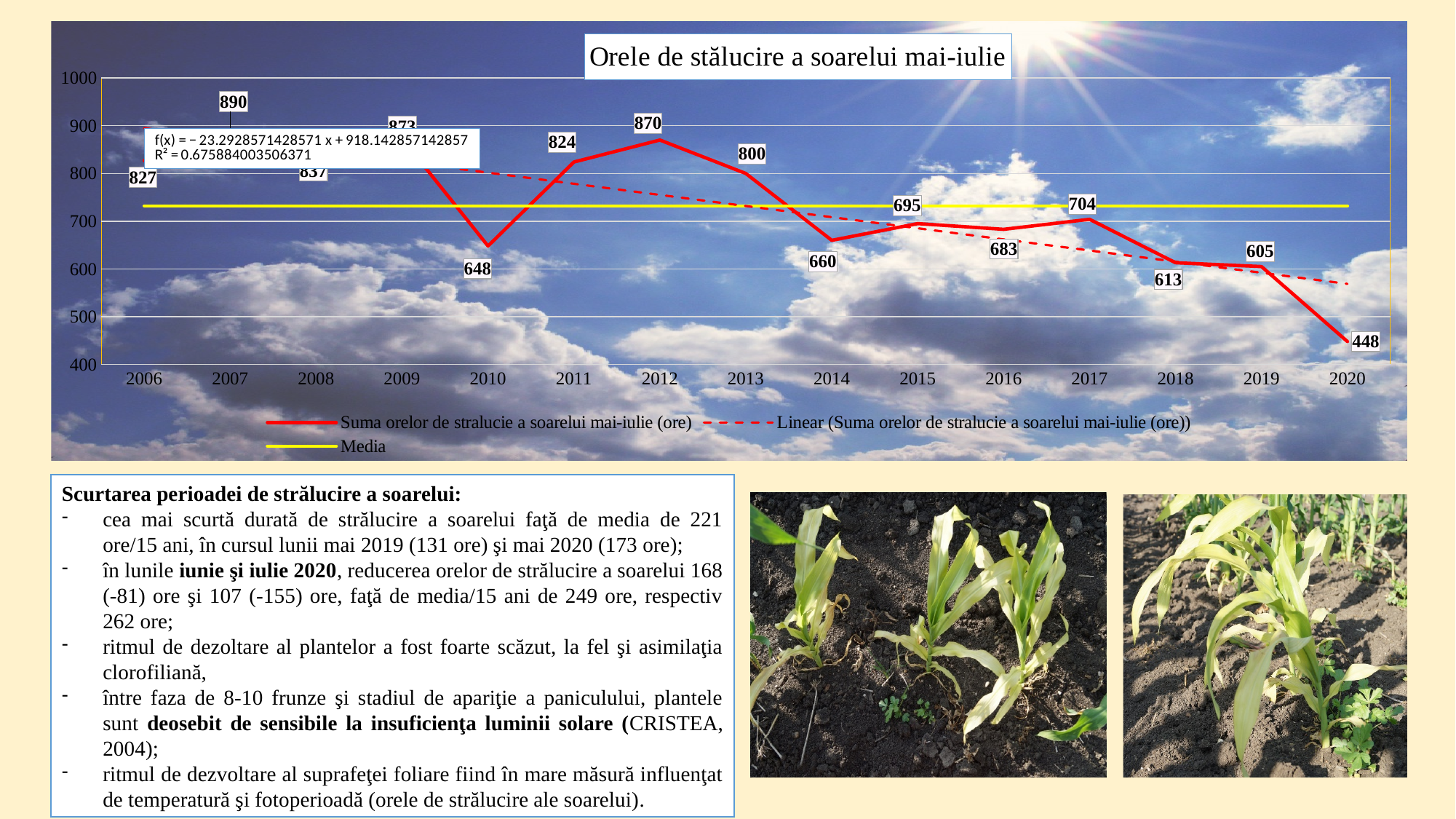
What is the difference between the values for 2019 and 2020? 157 How many entries does the chart legend list? 3 What is the value for 2012 in the chart? 870 What kind of chart is shown on the slide? line chart Which is larger, the value for 2015 or the value for 2016? 2015 What is the value for 2010 in the chart? 648 Is the value for 2018 greater or less than 700? less What is the title of the chart? Orele de stălucire a soarelui mai-iulie How many years are shown on the x axis of the chart? 15 What is the value for 2020 in the chart? 448 Which year has the lowest value in the chart? 2020 Which year has the highest value in the chart? 2007